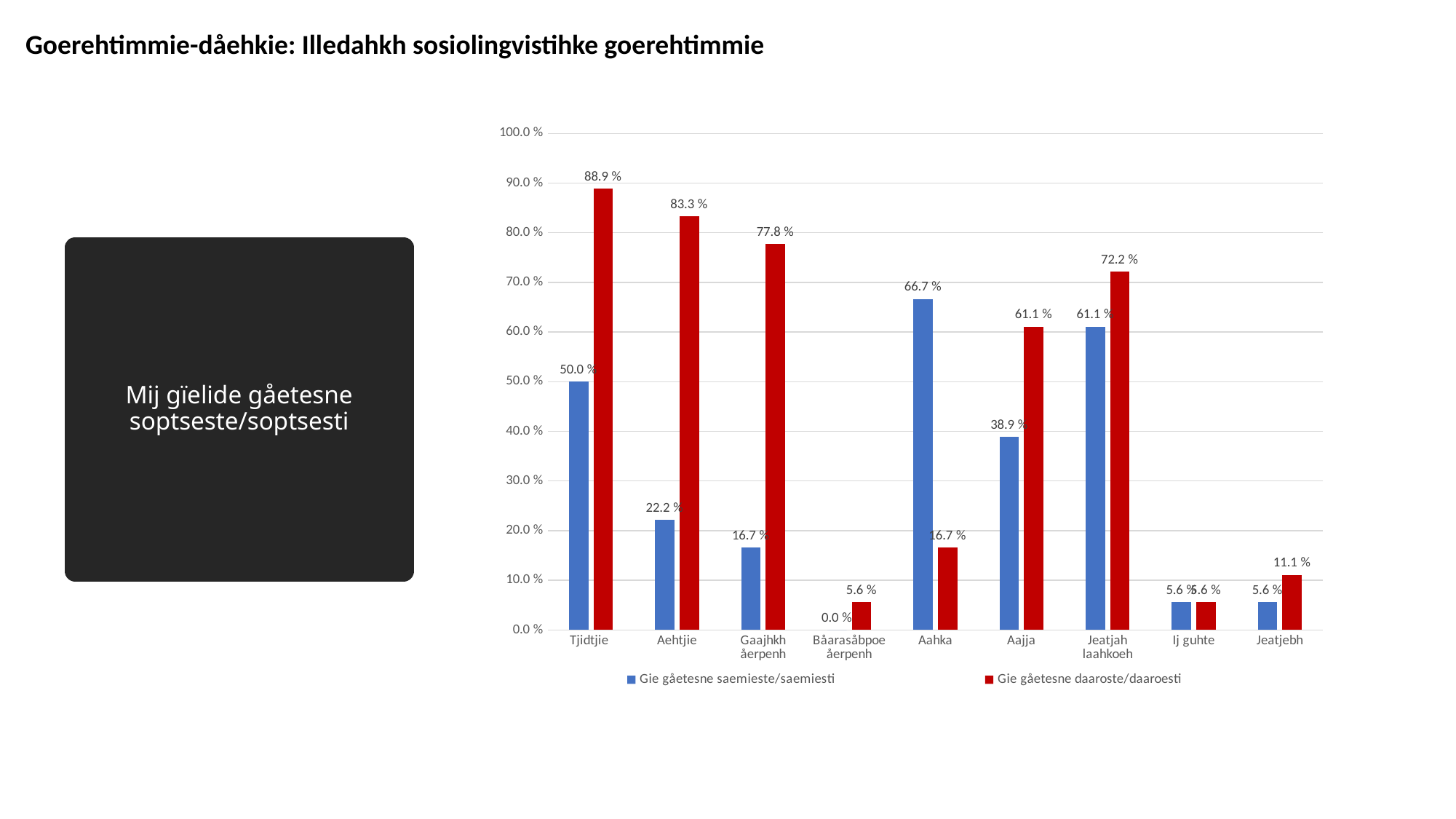
What is the value for Båarasåbpoe åerpenh in the Gie gåetesne saemieste/saemiesti series? 0.0 % How many series does the chart's legend list? 2 What is the value for Tjidtjie in the Gie gåetesne daaroste/daaroesti series? 88.9 % What is the value for Aahka in the Gie gåetesne saemieste/saemiesti series? 66.7 % Which category has the highest value in the Gie gåetesne daaroste/daaroesti series? Tjidtjie Is the value for Gaajhkh åerpenh in the Gie gåetesne daaroste/daaroesti series greater or less than 70.0 %? greater How many categories are shown on the x axis of the chart? 9 For Aahka, which series has the larger value: Gie gåetesne saemieste/saemiesti or Gie gåetesne daaroste/daaroesti? Gie gåetesne saemieste/saemiesti Which category has the lowest value in the Gie gåetesne saemieste/saemiesti series? Båarasåbpoe åerpenh What is the difference between the Gie gåetesne daaroste/daaroesti and Gie gåetesne saemieste/saemiesti values for Aehtjie? 61.1 % What kind of chart is shown on the slide? Bar chart Which category has the highest value in the Gie gåetesne saemieste/saemiesti series? Aahka